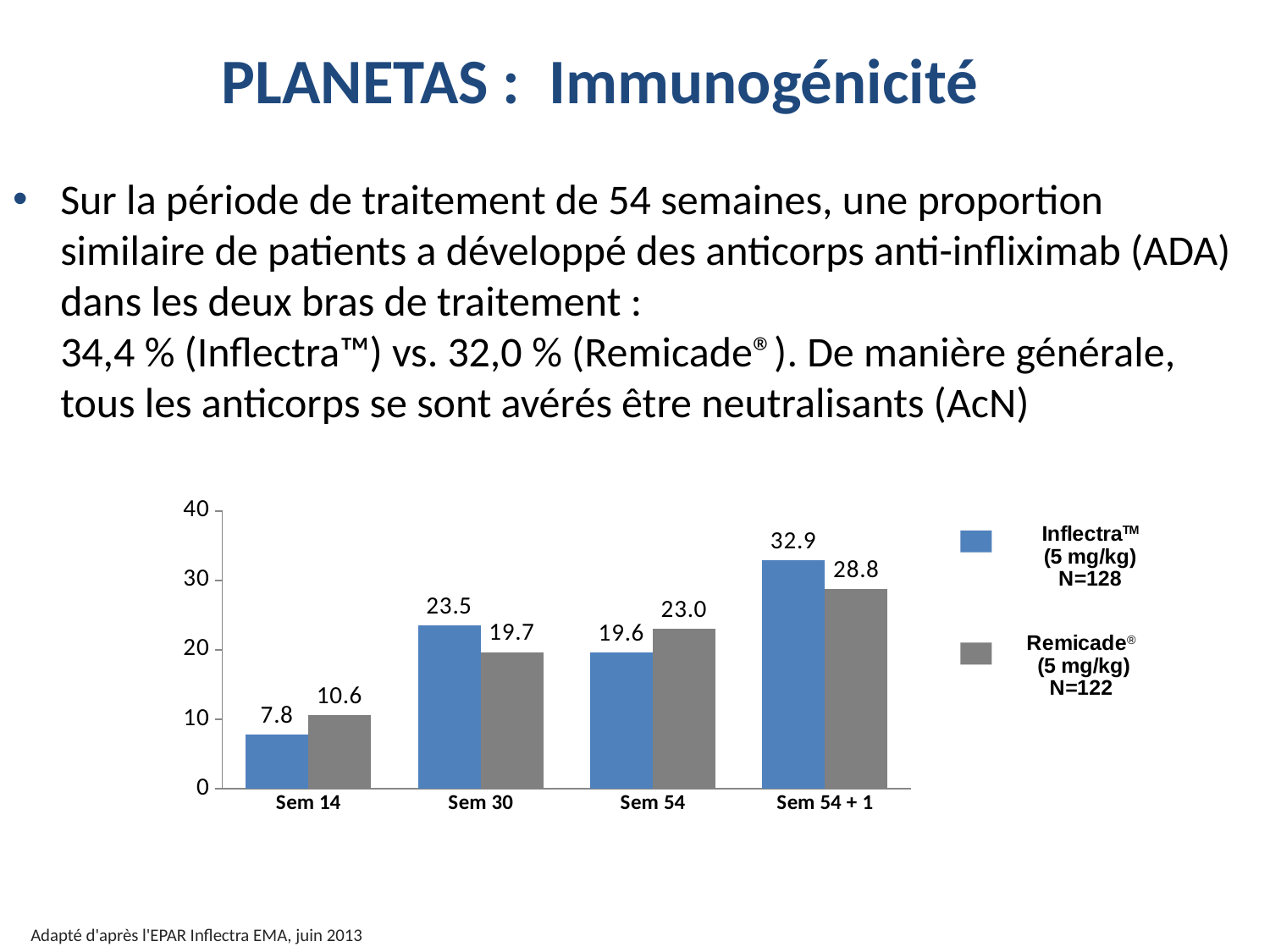
What is the value for Inflectra at Sem 14? 7.8 What is the value for Remicade at Sem 30? 19.7 What is the difference between the Inflectra and Remicade values at Sem 54 + 1? 4.1 At which time point is the Inflectra value highest? Sem 54 + 1 How many time points are shown on the x axis? 4 What is the N for the Remicade group shown in the legend? N=122 At which time point is the Remicade value lowest? Sem 14 What is the value for Remicade at Sem 54 + 1? 28.8 What kind of chart is shown on the slide? bar chart How many series does the legend list? 2 Is the value for Inflectra at Sem 54 + 1 greater or less than 30? greater At Sem 54, which series has the larger value, Inflectra or Remicade? Remicade